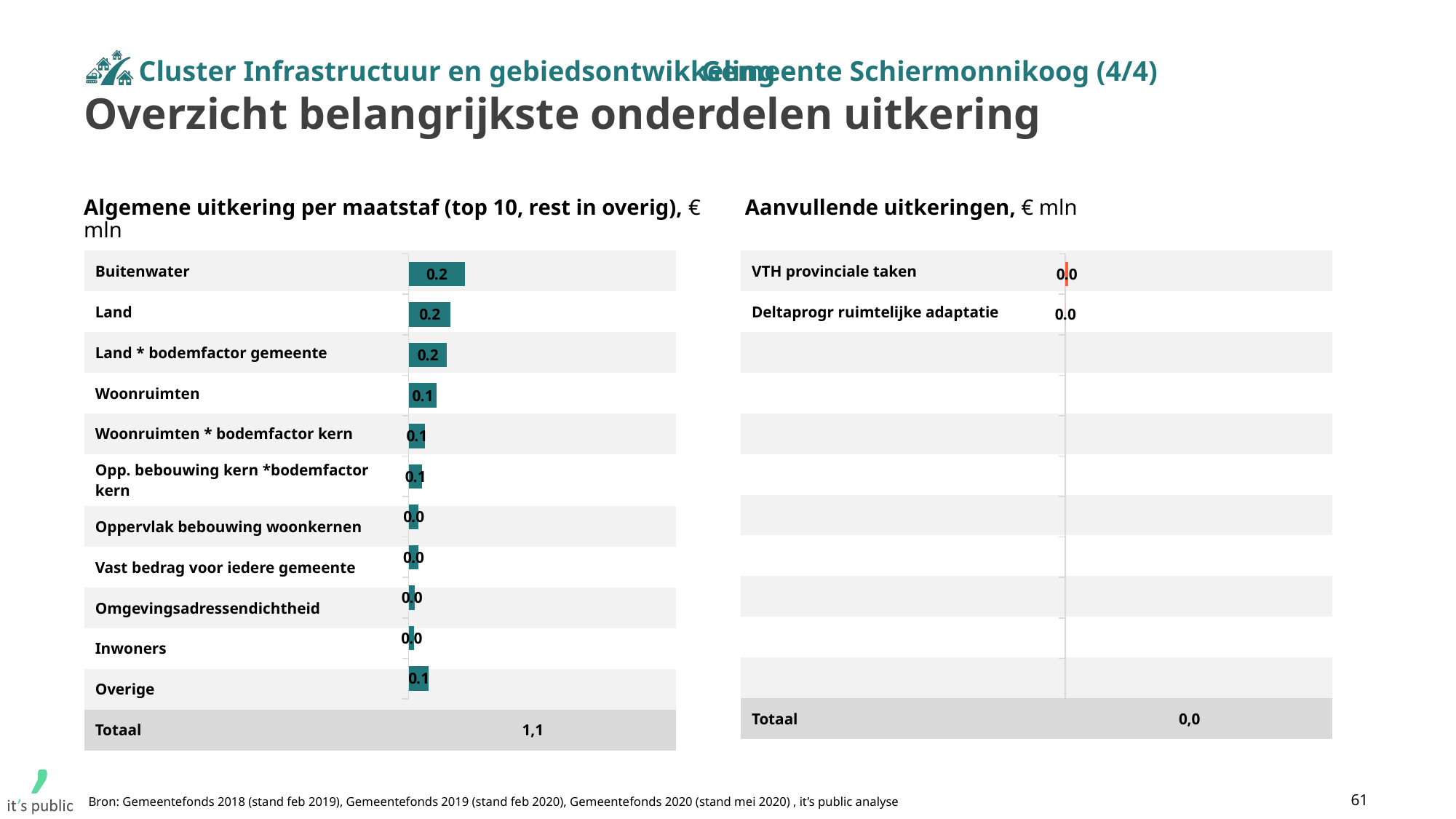
How many categories are shown in the chart 'Aanvullende uitkeringen'? 2 In the chart 'Algemene uitkering per maatstaf', what is the value for Buitenwater? 0.2 In the chart 'Algemene uitkering per maatstaf', what is the value for Overige? 0.1 How many categories (including Overige) are shown in the chart 'Algemene uitkering per maatstaf'? 11 In the chart 'Algemene uitkering per maatstaf', what is the value for Inwoners? 0.0 In the chart 'Algemene uitkering per maatstaf', which category has the longest bar? Buitenwater What is the Totaal shown for the chart 'Algemene uitkering per maatstaf'? 1,1 In the chart 'Algemene uitkering per maatstaf', what is the difference between Buitenwater and Woonruimten? 0.1 In the chart 'Algemene uitkering per maatstaf', what is the value for Woonruimten? 0.1 In the chart 'Aanvullende uitkeringen', what is the value for VTH provinciale taken? 0.0 What kind of chart is the 'Algemene uitkering per maatstaf' chart on the left? Bar chart In the chart 'Algemene uitkering per maatstaf', which is larger: Buitenwater or Woonruimten? Buitenwater